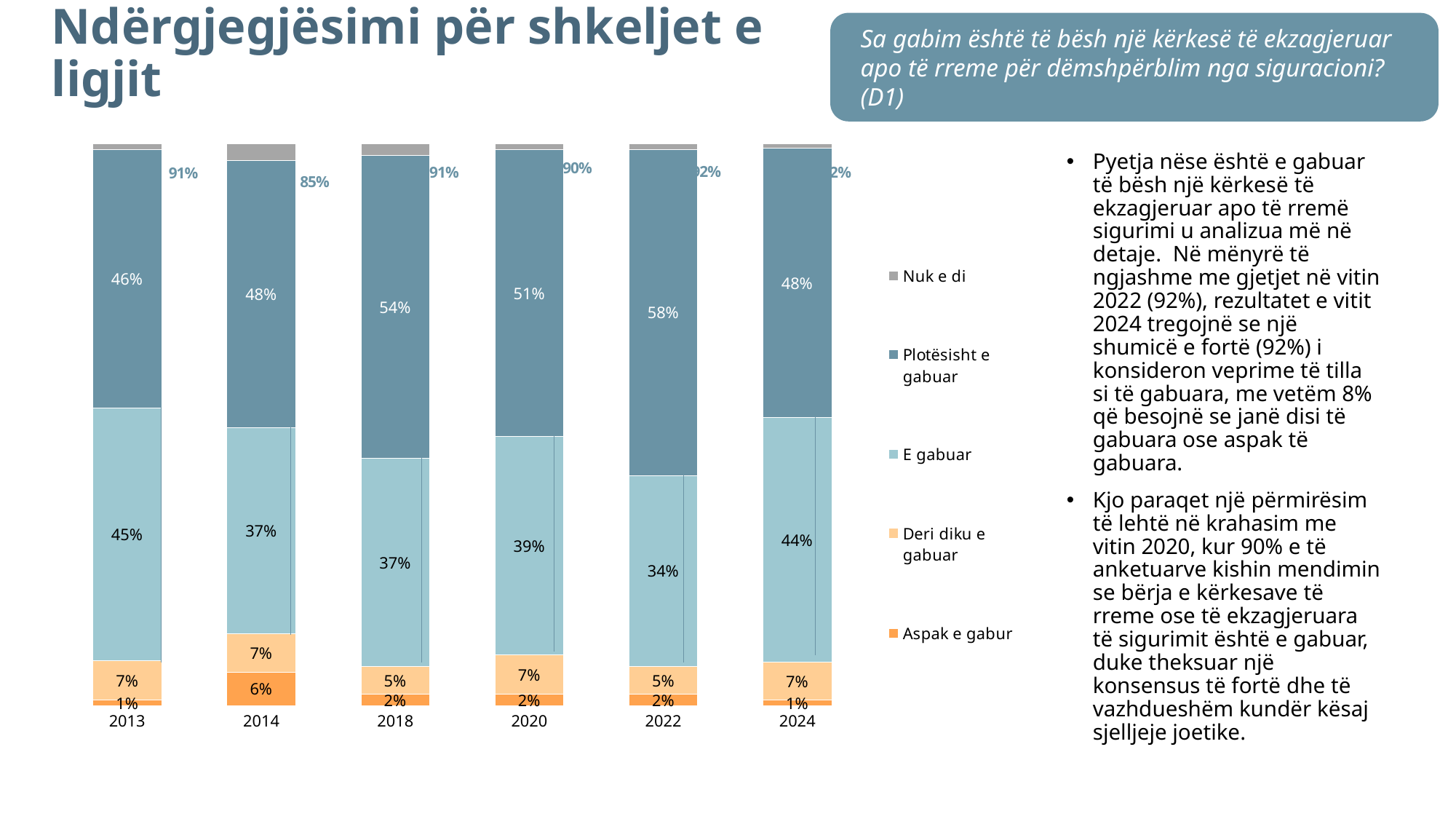
What is the combined share of "Plotësisht e gabuar" and "E gabuar" in 2024? 92% How much higher is the "Plotësisht e gabuar" share in 2022 than in 2013? 12 percentage points In which year is the "Plotësisht e gabuar" share the highest? 2022 What is the value for "Plotësisht e gabuar" in 2022? 58% What is the value for "Aspak e gabur" in 2014? 6% In which year is the "E gabuar" share the lowest? 2022 How many years are shown on the x axis of the chart? 6 What is the percentage label shown above the 2014 bar? 85% Which year has the larger "E gabuar" share, 2013 or 2024? 2013 What kind of chart is shown on the slide? Stacked bar chart How many series does the legend list? 5 What is the value for "E gabuar" in 2024? 44%